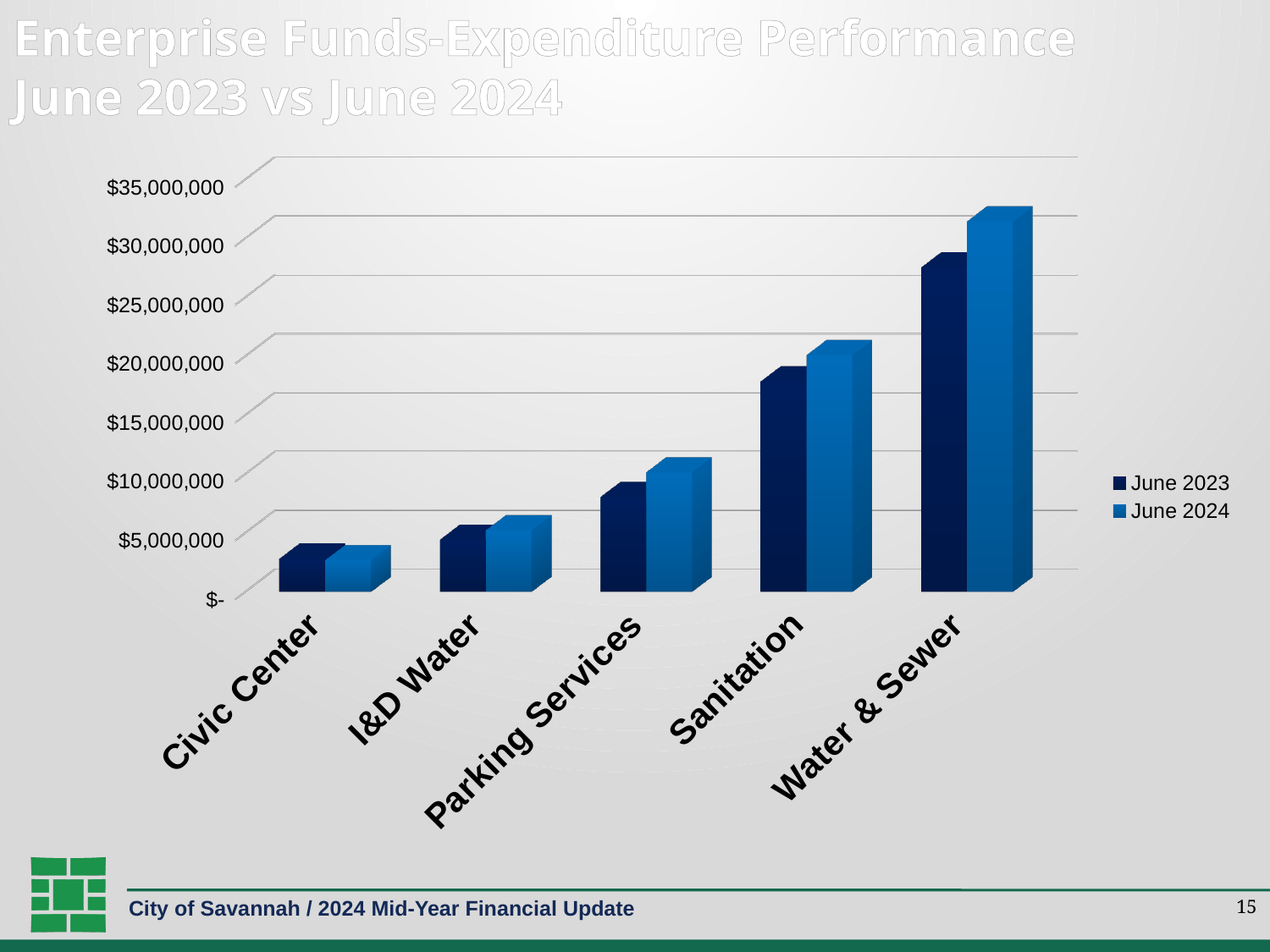
Which category has the lowest expenditure in June 2023? Civic Center What kind of chart is shown on the slide? Bar chart Is the June 2023 value for Parking Services greater or less than $10,000,000? less How many series does the chart's legend list? 2 For Water & Sewer, which is larger: June 2023 or June 2024? June 2024 Do the June 2024 values rise or fall moving from Civic Center to Water & Sewer along the x axis? Rise Is the June 2023 value for Water & Sewer greater or less than $30,000,000? less Is the June 2024 value for Sanitation greater or less than $15,000,000? greater How many categories are shown on the x axis of the chart? 5 For Parking Services, which is larger: June 2023 or June 2024? June 2024 Which category has the highest expenditure in June 2024? Water & Sewer